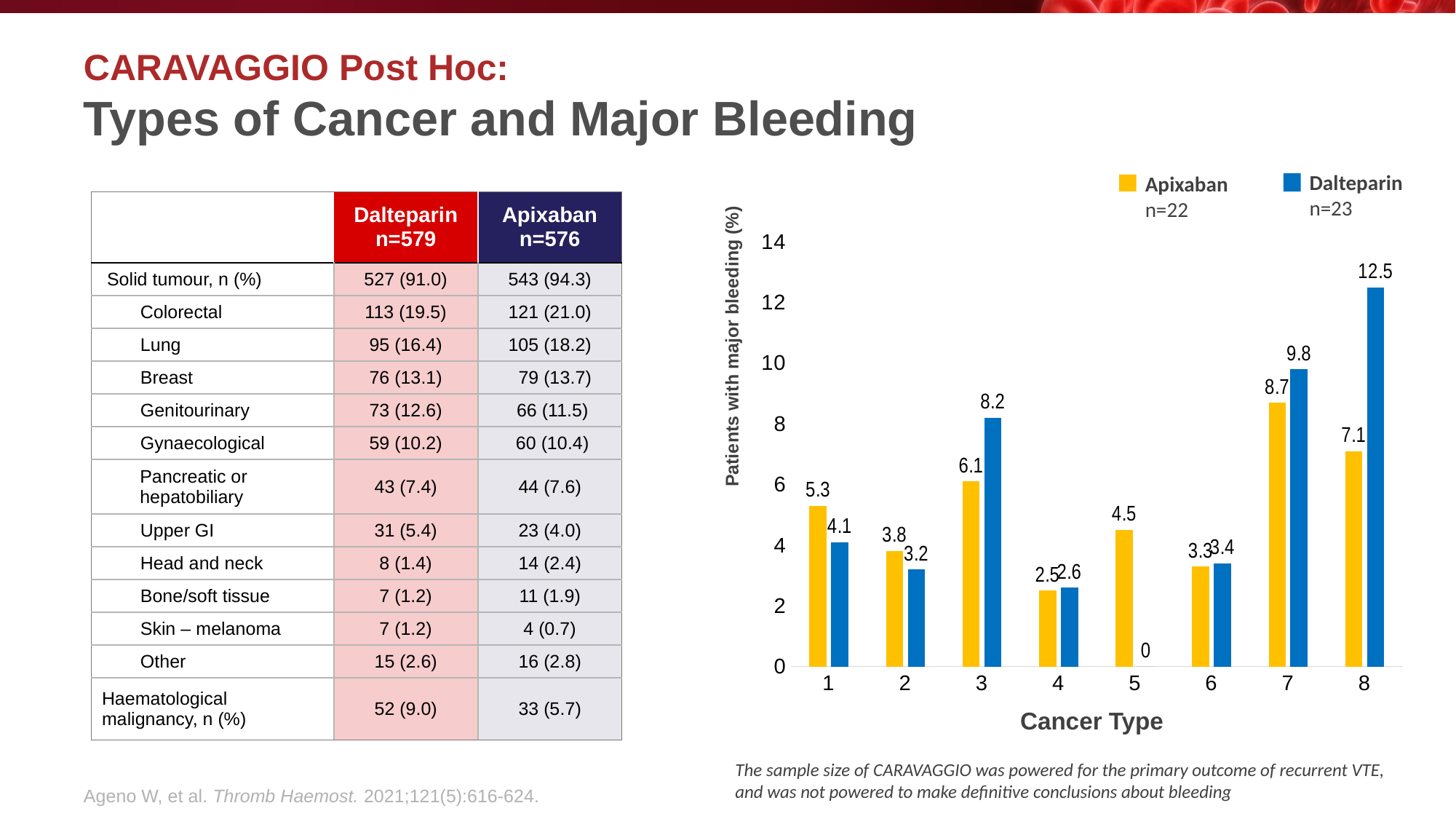
How many cancer type categories are shown on the x axis of the bar chart? 8 In the bar chart, for cancer type 3, which series has the larger value, Apixaban or Dalteparin? Dalteparin In the bar chart, which cancer type has the lowest Apixaban value? 4 In the bar chart, what is the Apixaban value for cancer type 7? 8.7 In the bar chart, which cancer type has the highest Dalteparin value? 8 How many series does the legend of the bar chart list? 2 In the bar chart, what is the Dalteparin value for cancer type 5? 0 In the bar chart, what is the difference between the Dalteparin and Apixaban values for cancer type 8? 5.4 In the bar chart, what is the Dalteparin value for cancer type 8? 12.5 In the bar chart, is the Dalteparin value for cancer type 7 greater or less than 8? greater In the bar chart, what is the Apixaban value for cancer type 1? 5.3 What type of chart is shown on the right side of the slide? Bar chart